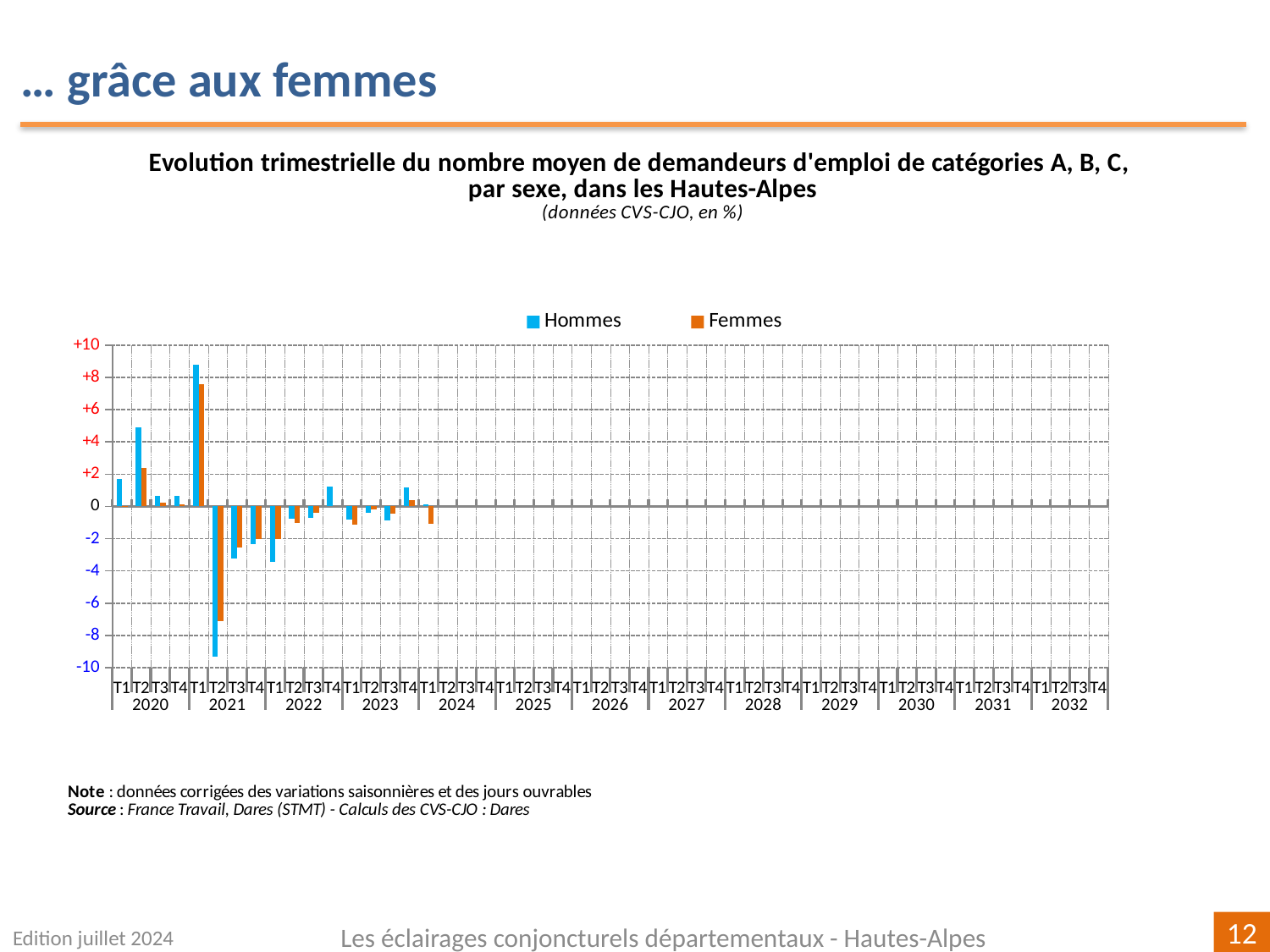
Is the Femmes value for T2 2021 greater or less than -6? less Is the Femmes value for T1 2021 greater or less than +6? greater How many series does the legend list? 2 In T2 2020, which series has the larger value, Hommes or Femmes? Hommes What kind of chart is shown on the slide? bar chart Is the Hommes value for T2 2021 greater or less than -8? less What are the two series named in the legend? Hommes and Femmes In which quarter is the Femmes value highest? T1 2021 In which quarter is the Hommes value highest? T1 2021 In which quarter is the Hommes value lowest? T2 2021 In which quarter is the Femmes value lowest? T2 2021